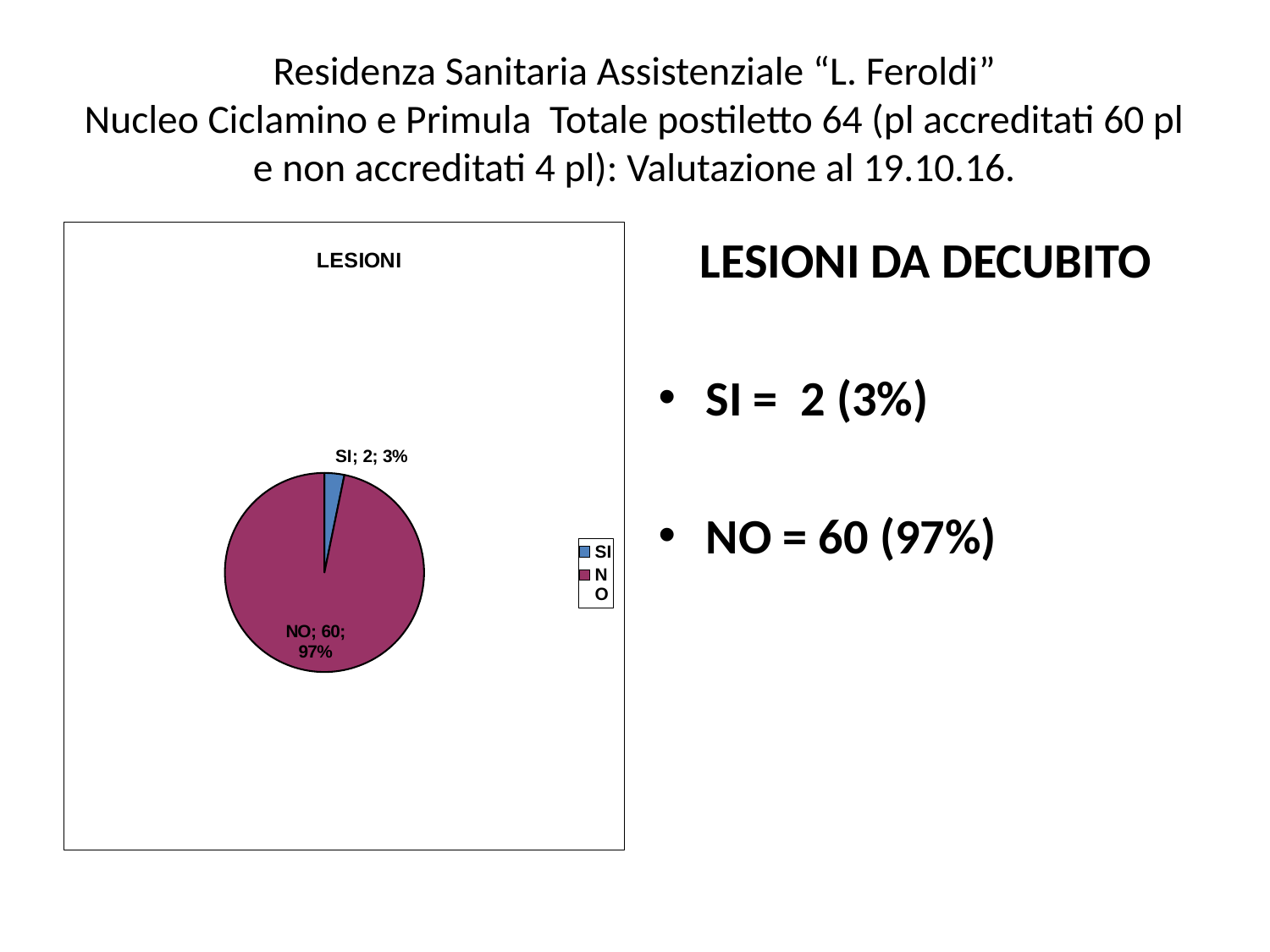
What kind of chart is shown on the slide? pie chart What is the value for the SI slice? 2 What is the value for the NO slice? 60 What share of the pie does the SI slice represent? 3% How many slices does the pie chart have? 2 What is the difference between the NO value and the SI value? 58 Which slice is the largest? NO How many entries does the chart legend list? 2 Which colour is used for the NO slice? purple Which slice is the smallest? SI What share of the pie does the NO slice represent? 97% What is the title of the chart? LESIONI